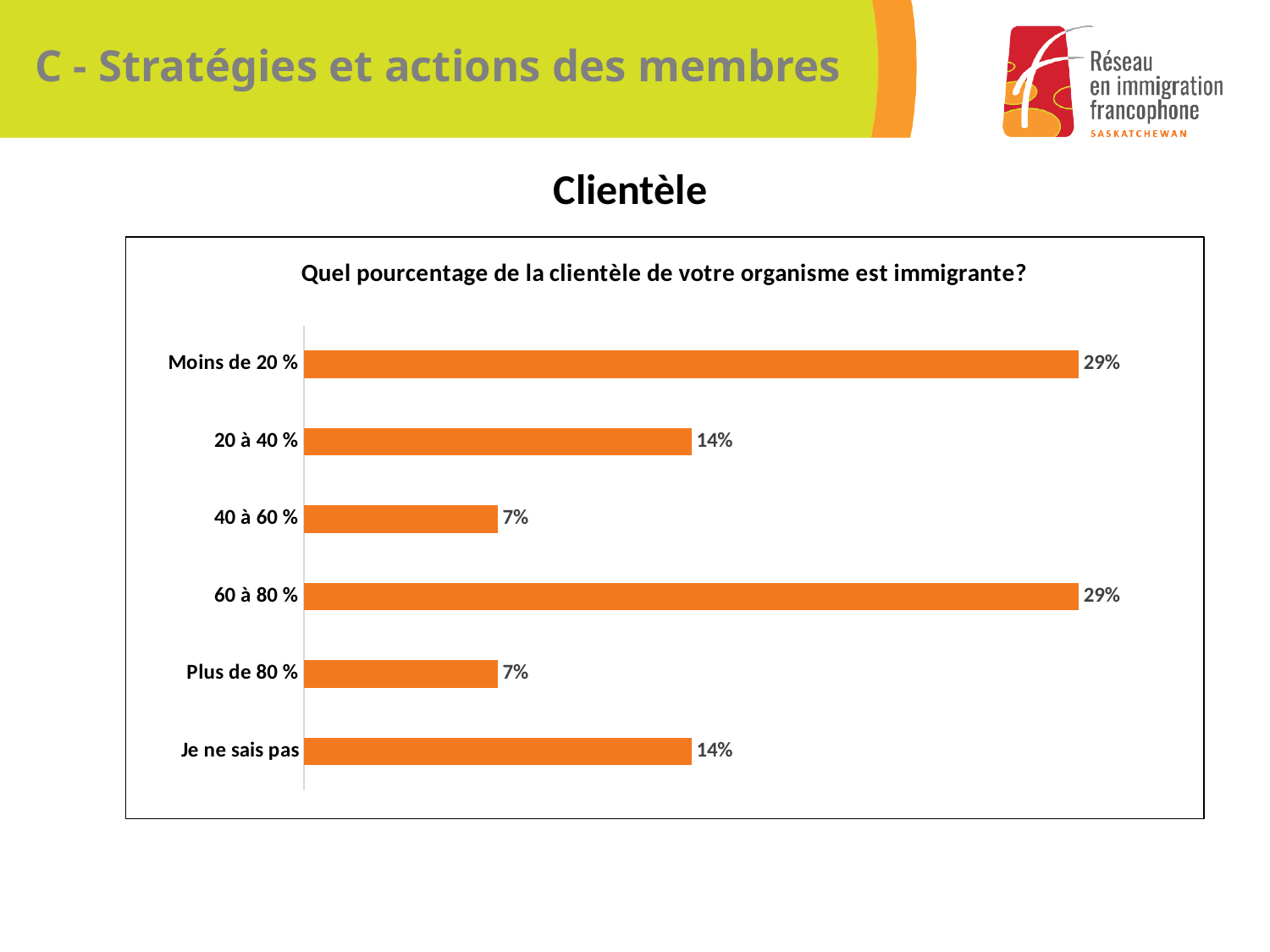
What is the value for "Moins de 20 %"? 29% What is the difference between the values for "60 à 80 %" and "Plus de 80 %"? 22% What is the value for "40 à 60 %"? 7% What is the value for "20 à 40 %"? 14% What is the title of the chart? Quel pourcentage de la clientèle de votre organisme est immigrante? What kind of chart is shown on the slide? Bar chart How many categories are shown in the chart? 6 Which is larger, the value for "Je ne sais pas" or the value for "Plus de 80 %"? Je ne sais pas Which category has the lowest value, "40 à 60 %" or "20 à 40 %"? 40 à 60 % What is the value for "Je ne sais pas"? 14% What is the difference between the values for "Moins de 20 %" and "20 à 40 %"? 15% What colour are the bars in the chart? Orange